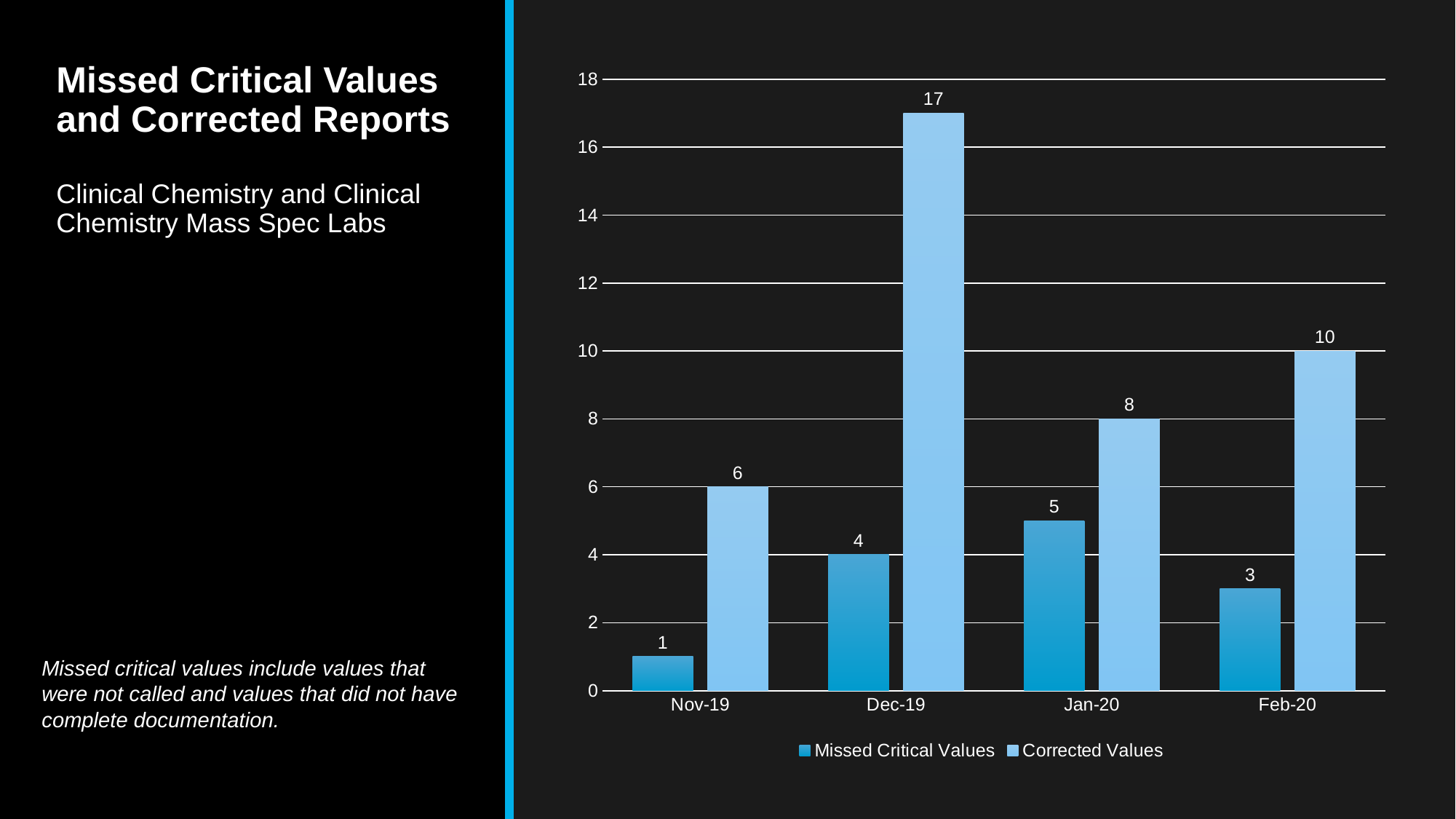
What is the difference between Corrected Values and Missed Critical Values in Dec-19? 13 What is the difference between Corrected Values in Feb-20 and Jan-20? 2 Which is larger, Missed Critical Values in Jan-20 or Missed Critical Values in Feb-20? Jan-20 Which month has the highest Corrected Values? Dec-19 What are the two series named in the legend? Missed Critical Values and Corrected Values Which month has the lowest Missed Critical Values? Nov-19 What kind of chart is shown on the slide? Bar chart What is the value for Missed Critical Values in Nov-19? 1 What is the value for Corrected Values in Feb-20? 10 What is the value for Missed Critical Values in Dec-19? 4 How many series does the legend list? 2 How many months are shown on the x axis? 4